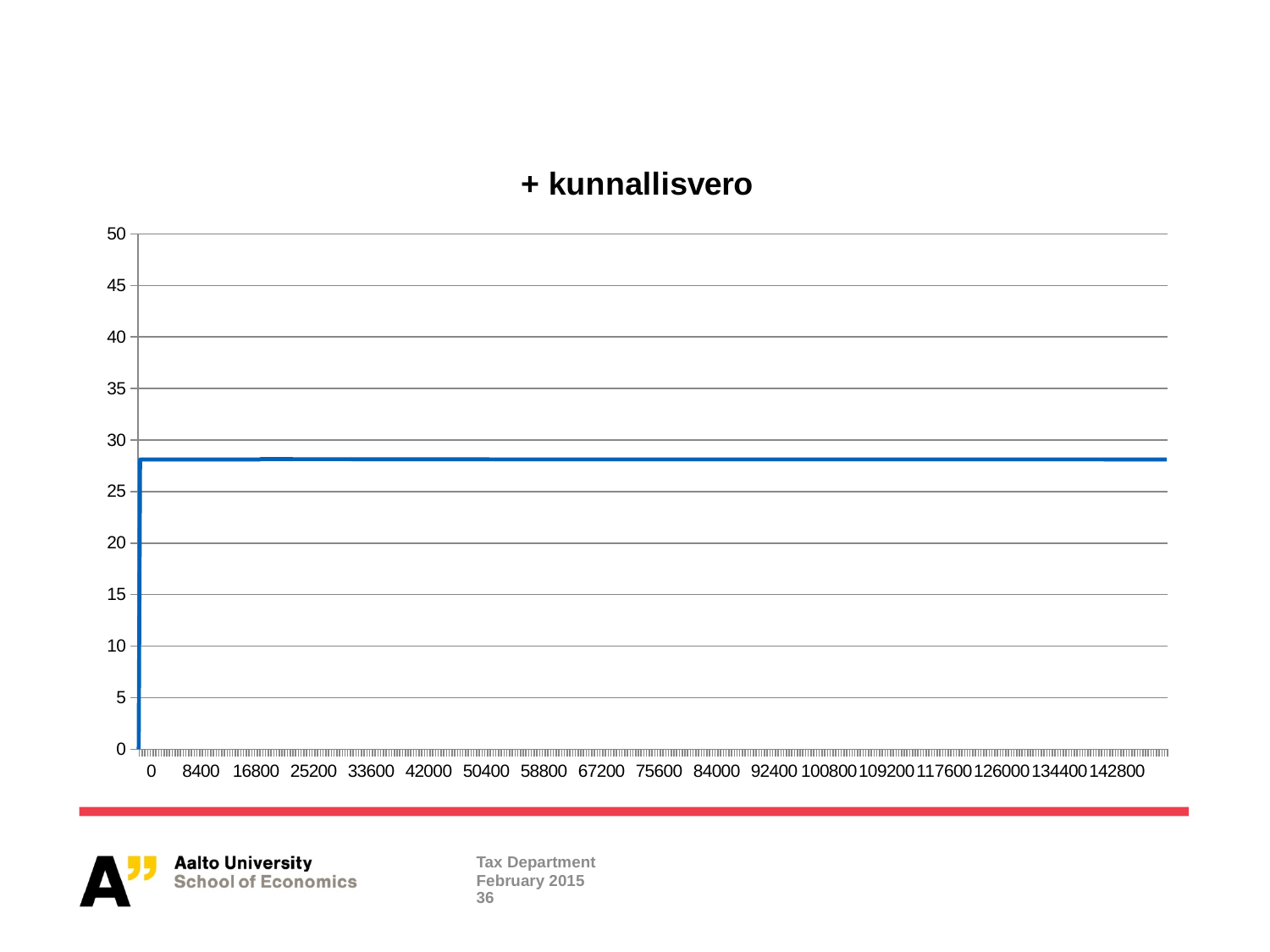
What kind of chart is shown on the slide? line chart What is the title of the chart? + kunnallisvero What is the highest value shown on the y axis? 50 Is the value of the line at 142800 greater or less than 30? less Is the value of the line at 84000 greater or less than 30? less Is the value of the line at 8400 larger or smaller than the value at 0? larger Is the value of the line at 42000 greater or less than 20? greater After the initial jump near 0, does the line rise, fall, or stay flat as the x axis increases? stays flat